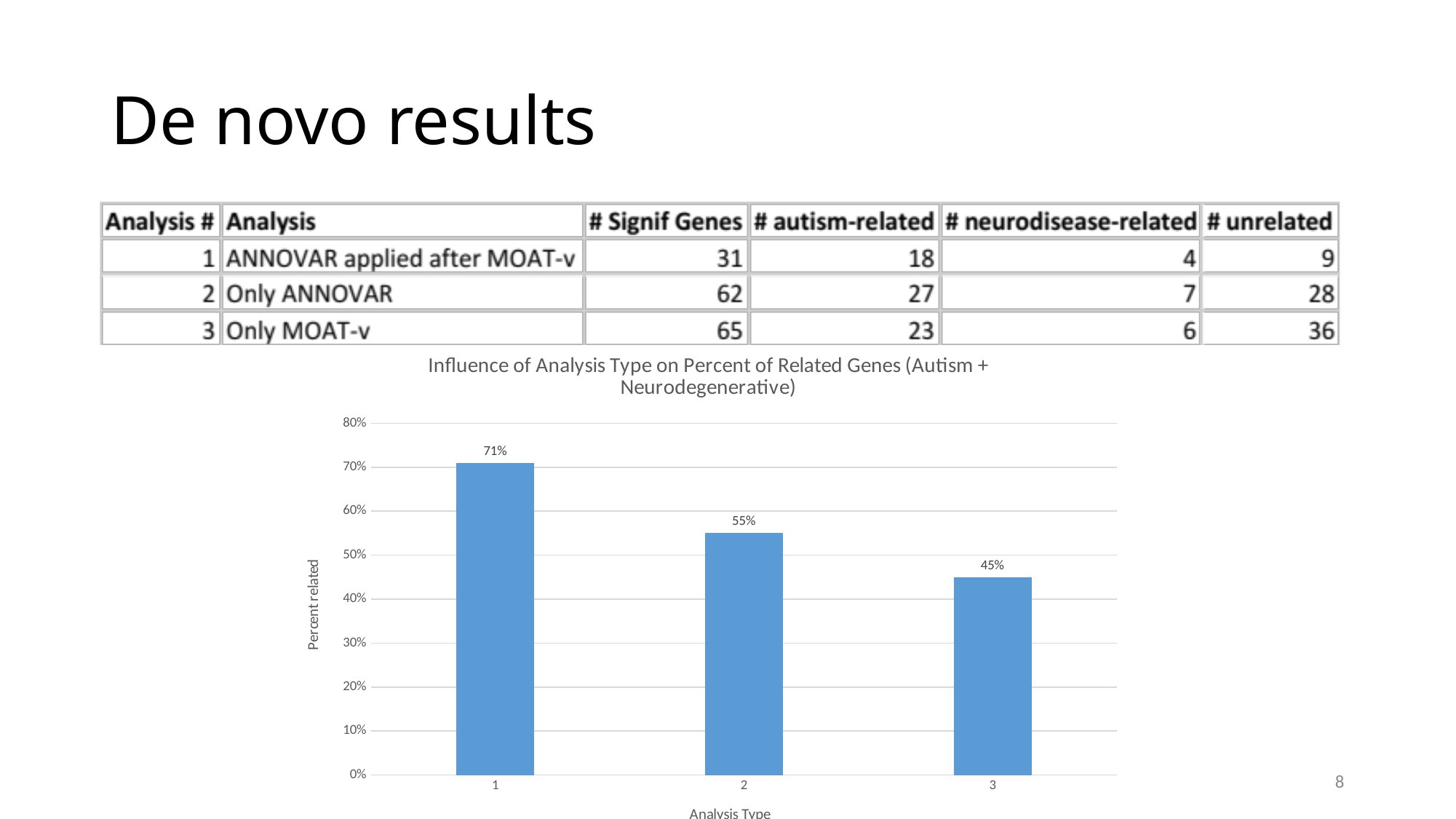
Do the values rise or fall from analysis type 1 to analysis type 3? fall What is the percent related for analysis type 2? 55% What is the difference in percent related between analysis type 1 and analysis type 3? 26% Which analysis type has the lowest percent related? 3 What is the percent related for analysis type 3? 45% What is the percent related for analysis type 1? 71% Is the value for analysis type 2 greater or less than 50%? greater Which analysis type has the highest percent related? 1 What kind of chart is shown on the slide? bar chart Which has a larger percent related, analysis type 2 or analysis type 3? 2 How many analysis types are shown in the chart? 3 What is the difference in percent related between analysis type 2 and analysis type 3? 10%